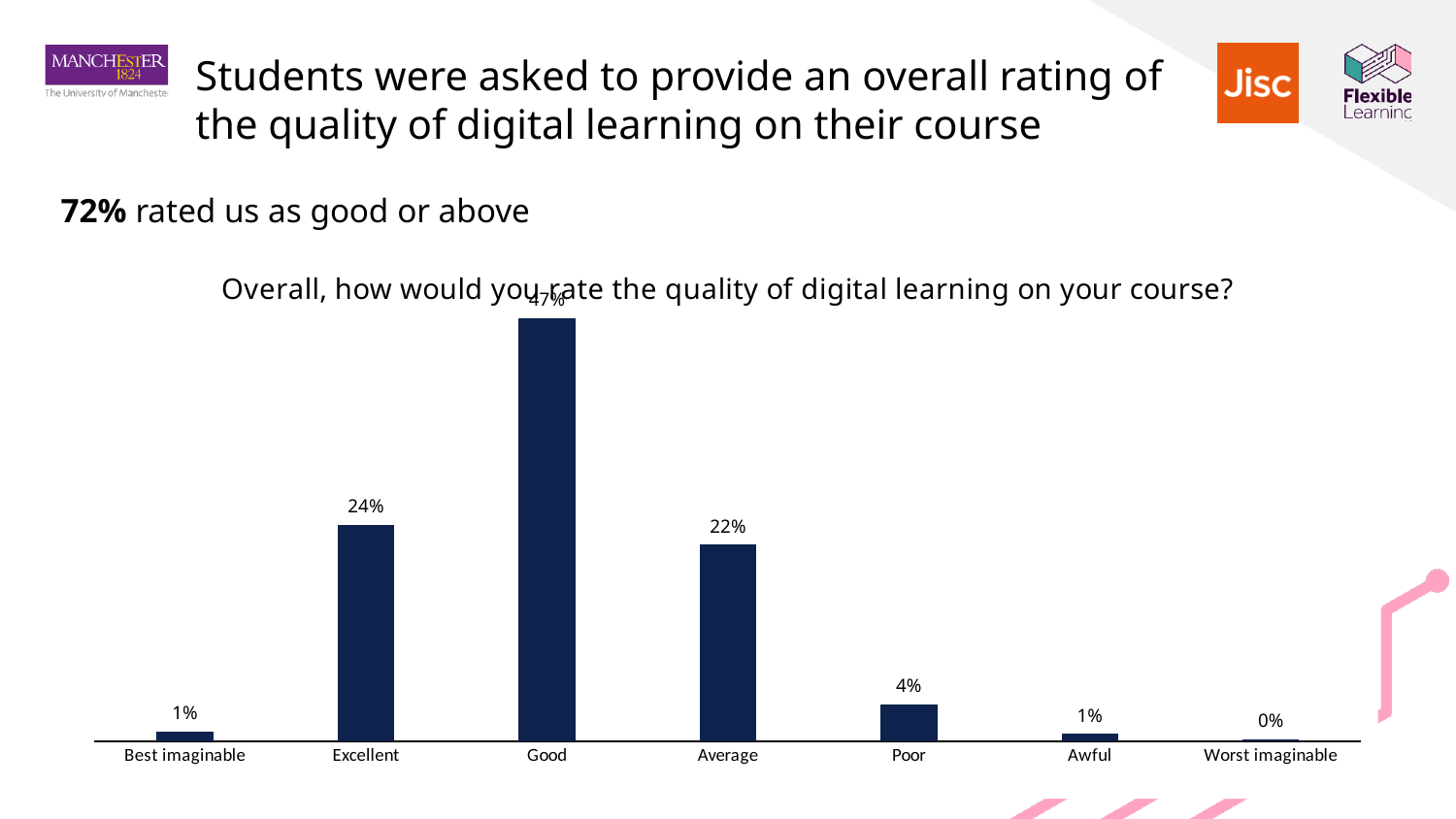
What percentage of students rated the quality of digital learning as Excellent? 24% Which rating category has the lowest percentage of students? Worst imaginable What percentage of students rated the quality of digital learning as Worst imaginable? 0% What is the title of the chart? Overall, how would you rate the quality of digital learning on your course? What percentage of students rated the quality of digital learning as Good? 47% How many rating categories are shown on the x axis of the chart? 7 What type of chart is used to show the ratings of digital learning quality? Bar chart Which rating category has the highest percentage of students? Good Which rating received a larger share of students, Excellent or Average? Excellent What percentage of students rated the quality of digital learning as Average? 22% What percentage of students rated the quality of digital learning as Poor? 4% What is the difference in percentage points between the Good and Excellent ratings? 23